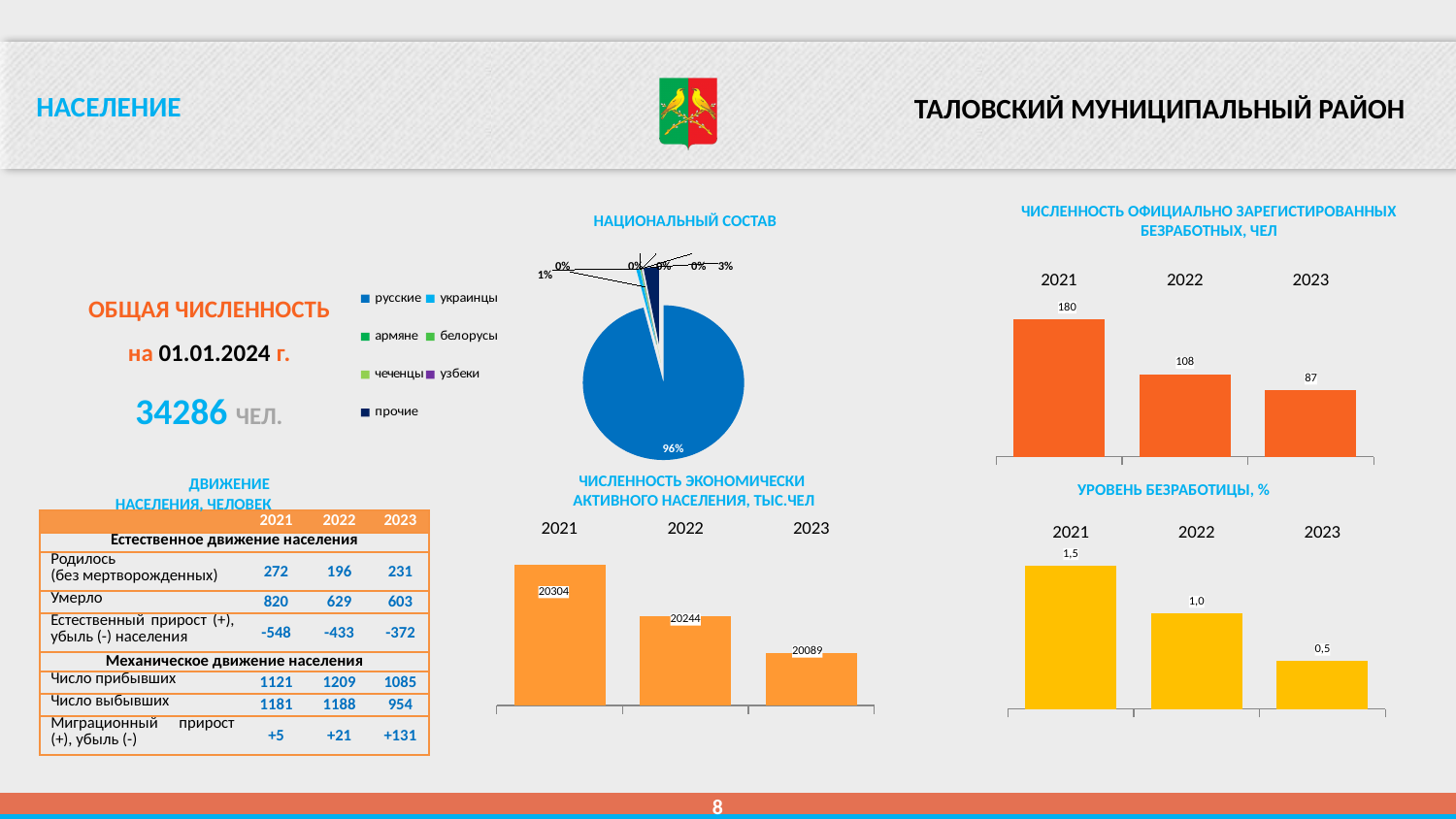
In the chart titled 'УРОВЕНЬ БЕЗРАБОТИЦЫ, %', how many years are shown? 3 In the chart titled 'УРОВЕНЬ БЕЗРАБОТИЦЫ, %', which year has the highest value? 2021 In the pie chart titled 'НАЦИОНАЛЬНЫЙ СОСТАВ', what share does 'русские' have? 96% In the chart titled 'ЧИСЛЕННОСТЬ ЭКОНОМИЧЕСКИ АКТИВНОГО НАСЕЛЕНИЯ, ТЫС.ЧЕЛ', what is the value for 2022? 20244 In the pie chart titled 'НАЦИОНАЛЬНЫЙ СОСТАВ', how many entries does the legend list? 7 In the chart titled 'УРОВЕНЬ БЕЗРАБОТИЦЫ, %', what is the value for 2023? 0,5 In the chart titled 'ЧИСЛЕННОСТЬ ЭКОНОМИЧЕСКИ АКТИВНОГО НАСЕЛЕНИЯ, ТЫС.ЧЕЛ', what kind of chart is it? bar chart In the chart titled 'ЧИСЛЕННОСТЬ ОФИЦИАЛЬНО ЗАРЕГИСТРИРОВАННЫХ БЕЗРАБОТНЫХ, ЧЕЛ', what is the value for 2021? 180 In the chart titled 'ЧИСЛЕННОСТЬ ОФИЦИАЛЬНО ЗАРЕГИСТРИРОВАННЫХ БЕЗРАБОТНЫХ, ЧЕЛ', do the values rise or fall from 2021 to 2023? fall In the chart titled 'ЧИСЛЕННОСТЬ ЭКОНОМИЧЕСКИ АКТИВНОГО НАСЕЛЕНИЯ, ТЫС.ЧЕЛ', which is larger, the value for 2021 or the value for 2023? 2021 In the chart titled 'ЧИСЛЕННОСТЬ ОФИЦИАЛЬНО ЗАРЕГИСТРИРОВАННЫХ БЕЗРАБОТНЫХ, ЧЕЛ', what is the difference between the 2021 and 2022 values? 72 In the chart titled 'ЧИСЛЕННОСТЬ ОФИЦИАЛЬНО ЗАРЕГИСТРИРОВАННЫХ БЕЗРАБОТНЫХ, ЧЕЛ', which year has the lowest value? 2023